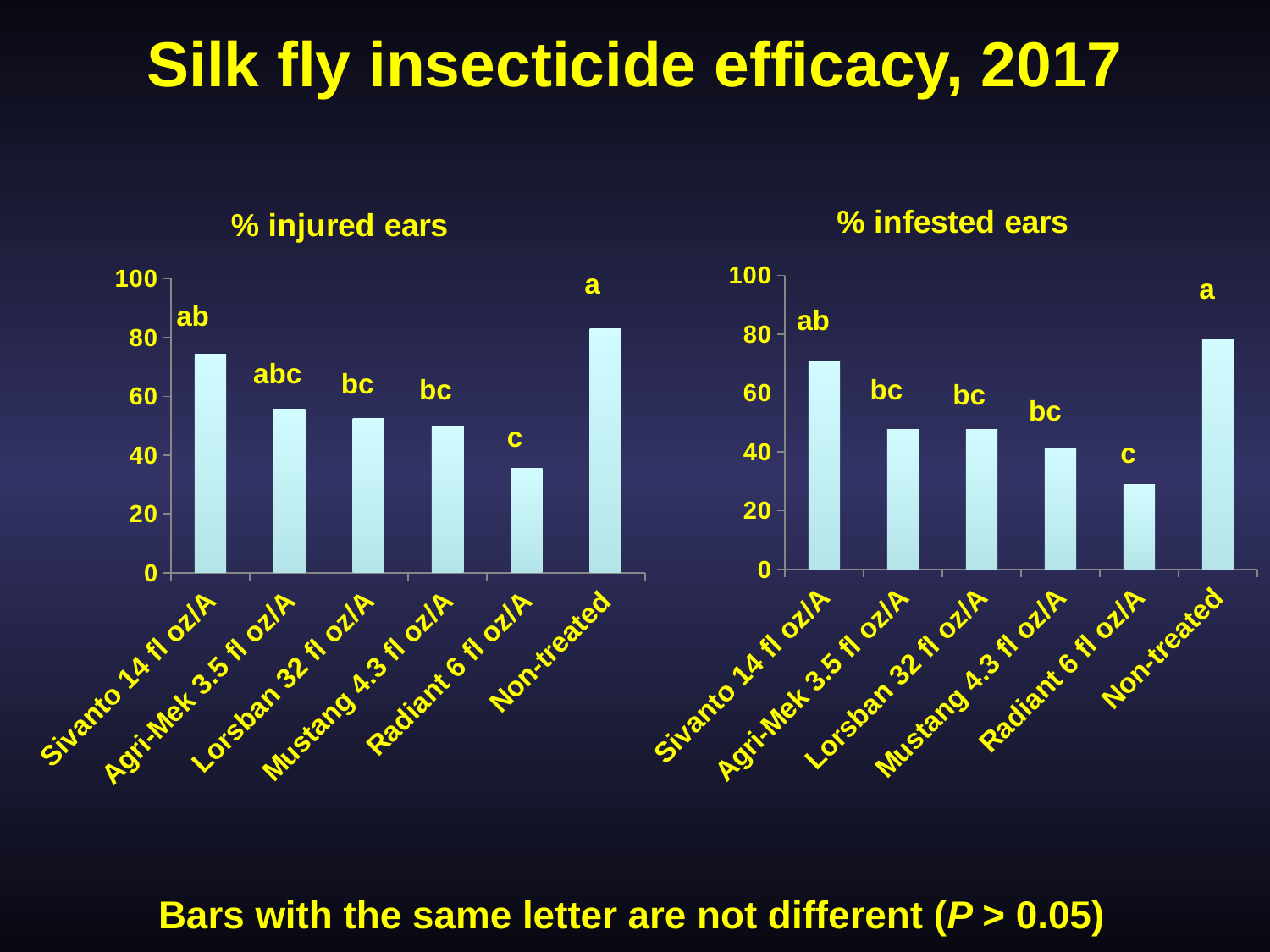
In the % injured ears chart, is the value for Radiant 6 fl oz/A greater or less than 40? less What kind of chart is the % infested ears chart? bar chart In the % injured ears chart, which treatment has the highest value? Non-treated How many treatments are shown in the % injured ears chart? 6 In the % infested ears chart, which treatment has the highest value? Non-treated In the % infested ears chart, what letter is printed above the Radiant 6 fl oz/A bar? c In the % injured ears chart, which is larger, the value for Sivanto 14 fl oz/A or the value for Agri-Mek 3.5 fl oz/A? Sivanto 14 fl oz/A In the % injured ears chart, which treatment has the lowest value? Radiant 6 fl oz/A In the % infested ears chart, which treatment has the lowest value? Radiant 6 fl oz/A In the % injured ears chart, is the value for Sivanto 14 fl oz/A greater or less than 60? greater In the % infested ears chart, is the value for Mustang 4.3 fl oz/A greater or less than 60? less